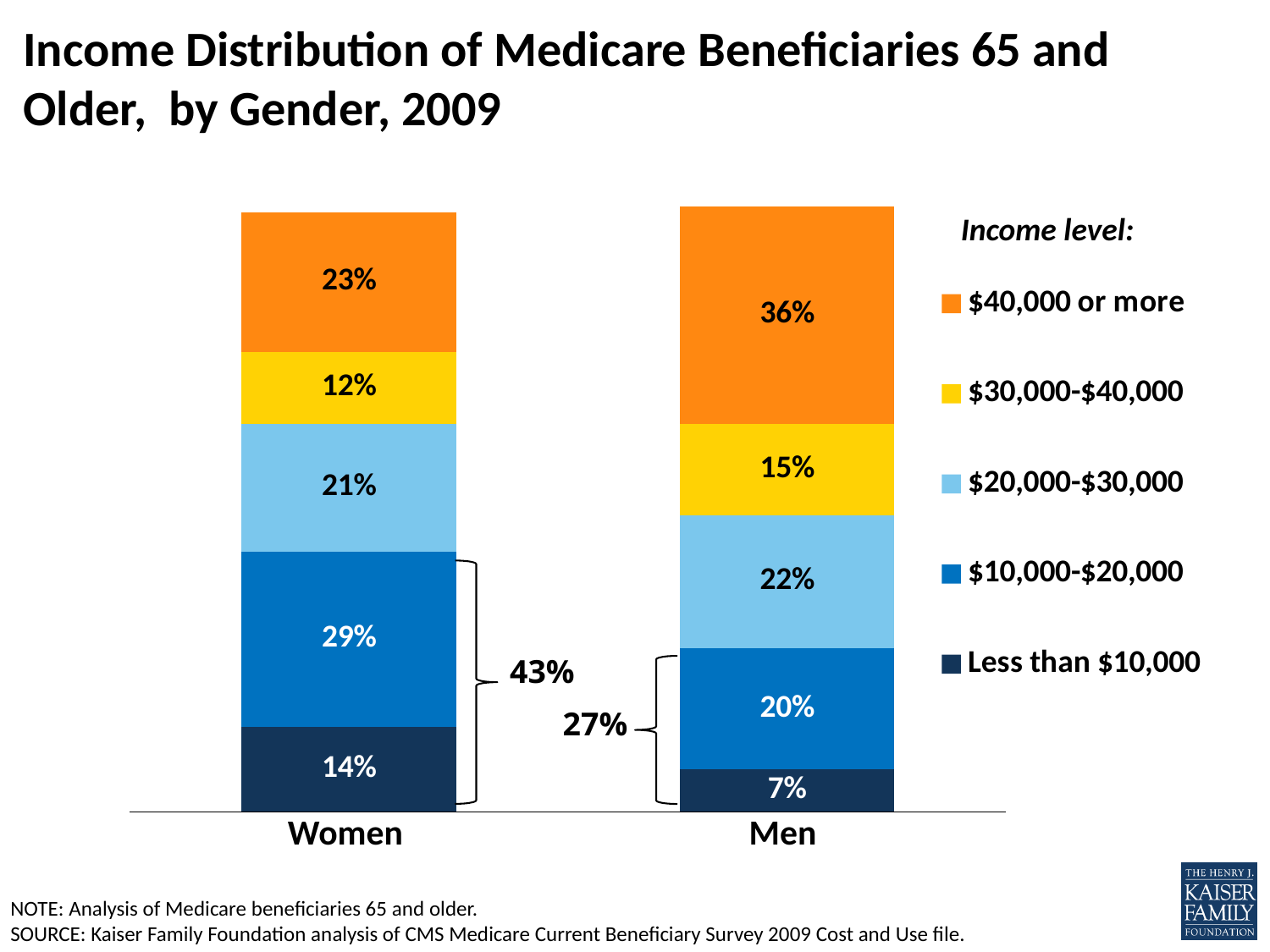
What percentage of men have an income of less than $10,000? 7% Which income level has the largest share among men? $40,000 or more What type of chart is shown on the slide? Stacked bar chart What percentage of women have an income of $10,000-$20,000? 29% What percentage of men have an income of $30,000-$40,000? 15% Which colour represents the $20,000-$30,000 income level? Light blue Who has a larger share with income less than $10,000, women or men? Women What is the difference between the share of men and the share of women with income of $40,000 or more? 13 percentage points Which income level has the smallest share among women? $30,000-$40,000 What percentage of women have an income of $40,000 or more? 23% How many income levels does the legend list? 5 What combined percentage of women have an income below $20,000, as shown by the bracket? 43%